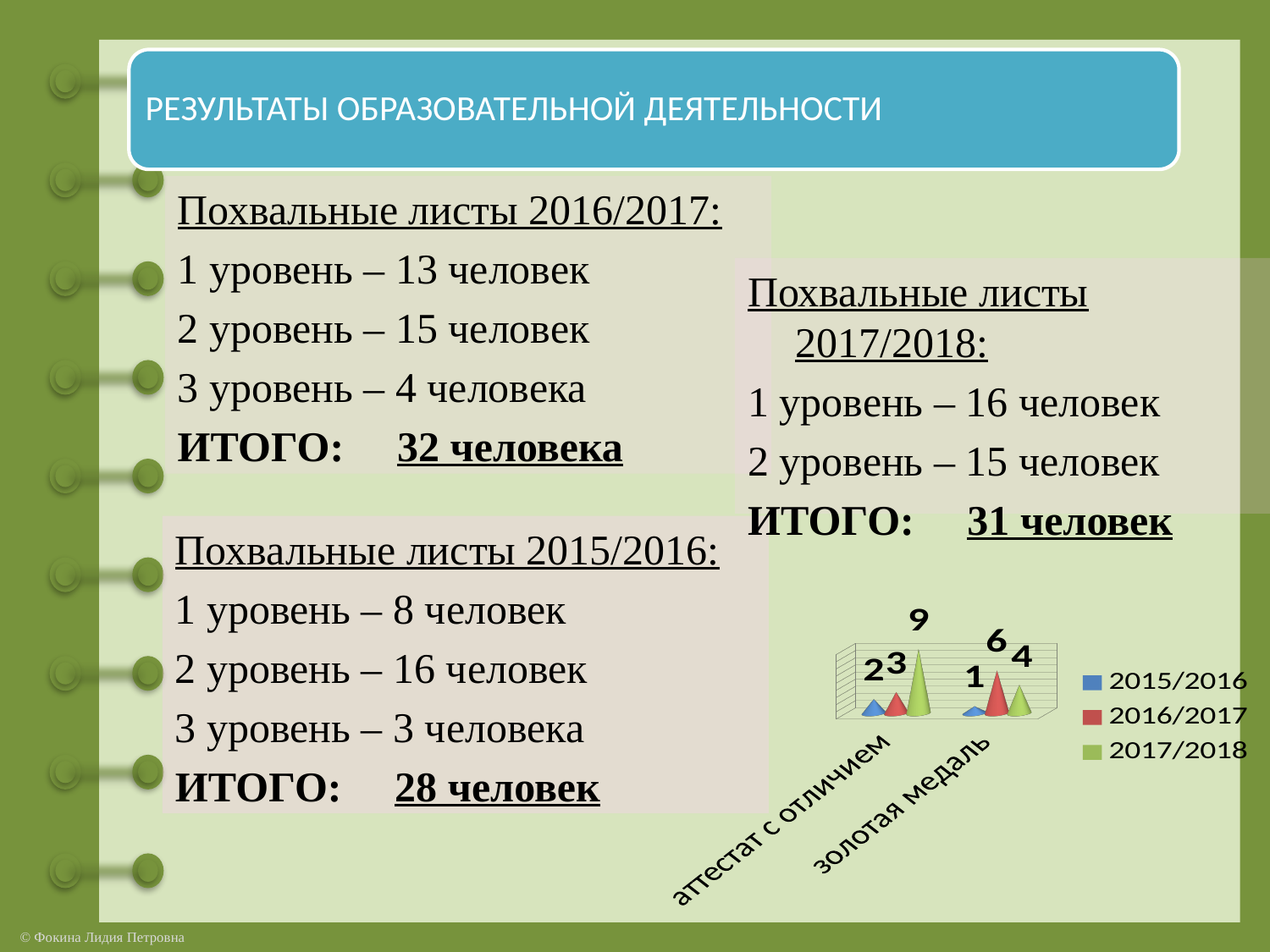
What value does the chart show for 2015/2016 in the category "аттестат с отличием"? 2 How many categories are shown on the chart's x axis? 2 Which series has the highest value in the category "аттестат с отличием"? 2017/2018 Which colour represents the 2016/2017 series in the chart legend? red What value does the chart show for 2015/2016 in the category "золотая медаль"? 1 How many series does the chart legend list? 3 In the category "золотая медаль", which is larger: the value for 2016/2017 or for 2017/2018? 2016/2017 What is the difference between the 2017/2018 and 2016/2017 values in the category "аттестат с отличием"? 6 What value does the chart show for 2017/2018 in the category "аттестат с отличием"? 9 What type of chart is shown on the slide? bar chart Which series has the lowest value in the category "золотая медаль"? 2015/2016 What value does the chart show for 2016/2017 in the category "золотая медаль"? 6